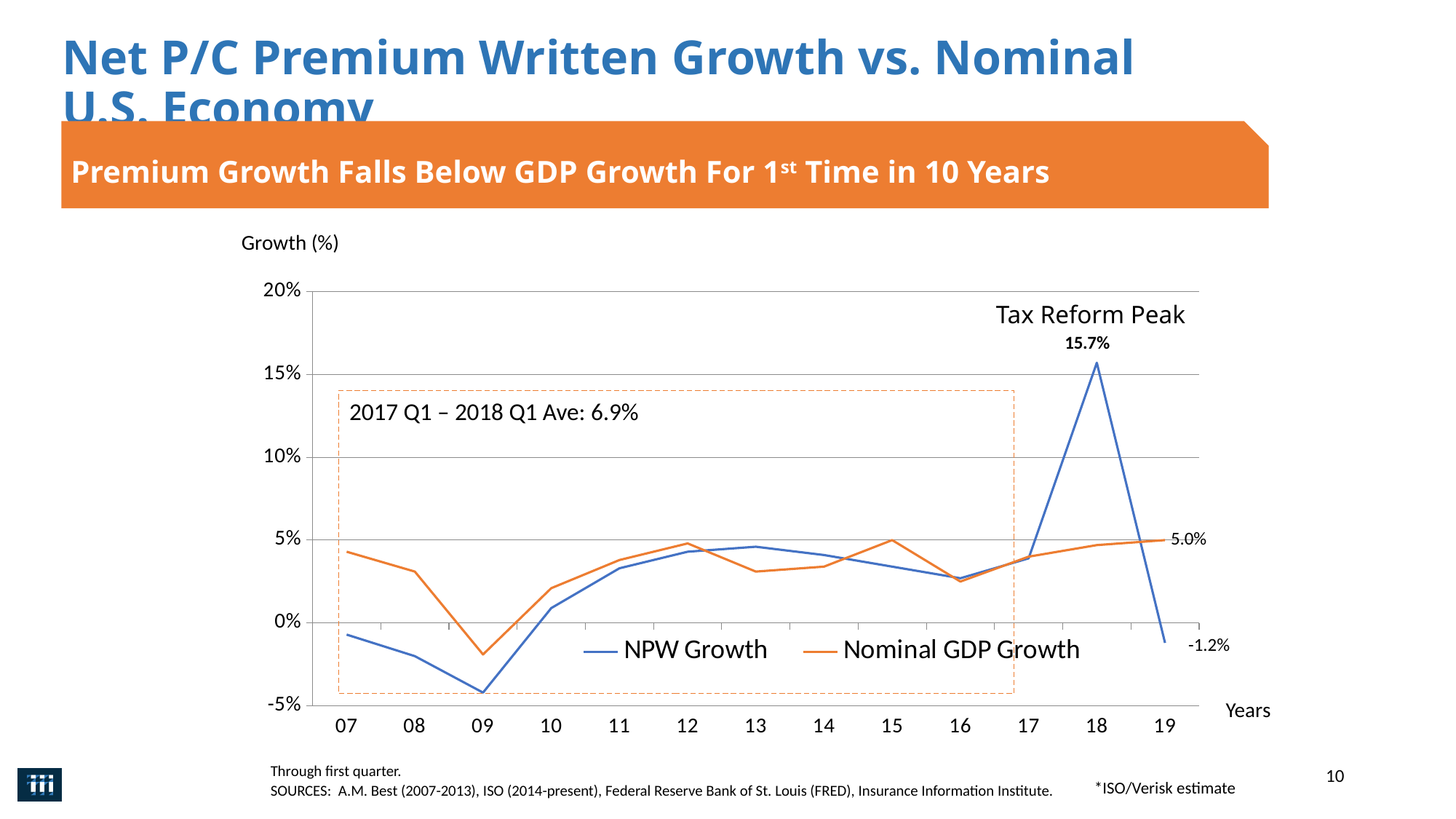
What is the NPW Growth value for 19? -1.2% How many years are plotted along the x axis of the chart? 13 What type of chart is shown on the slide? Line chart In 19, which is larger, NPW Growth or Nominal GDP Growth? Nominal GDP Growth Is the NPW Growth value for 09 greater or less than 0%? less What is the Nominal GDP Growth value for 19? 5.0% In 19, what is the difference between Nominal GDP Growth and NPW Growth? 6.2 percentage points In which year is NPW Growth highest? 18 What does the annotation above the 18 peak of the NPW Growth line say? Tax Reform Peak How many series does the chart's legend list? 2 What is the NPW Growth value for 18? 15.7% In which year is NPW Growth lowest? 09